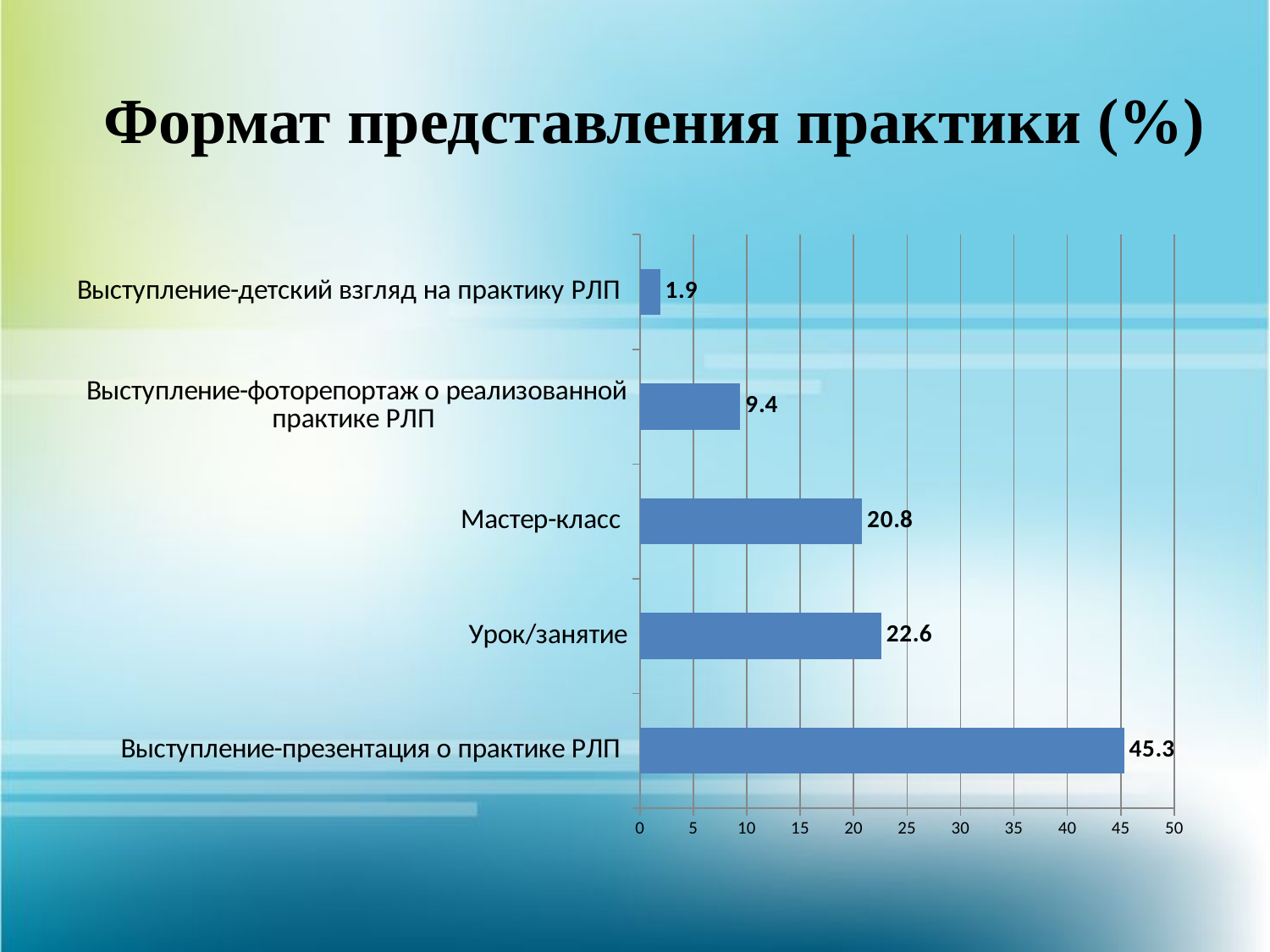
Which category has the lowest value? Выступление-детский взгляд на практику РЛП What is the value for Выступление-презентация о практике РЛП? 45.3 Which category has the highest value? Выступление-презентация о практике РЛП What is the value for Мастер-класс? 20.8 What is the value for Выступление-фоторепортаж о реализованной практике РЛП? 9.4 What kind of chart is shown on the slide? bar chart What is the difference between the values for Урок/занятие and Мастер-класс? 1.8 Which is larger: the value for Мастер-класс or the value for Выступление-фоторепортаж о реализованной практике РЛП? Мастер-класс What is the title of the slide? Формат представления практики (%) How many categories are shown in the chart? 5 Is the value for Выступление-презентация о практике РЛП greater or less than 40? greater What is the value for Урок/занятие? 22.6